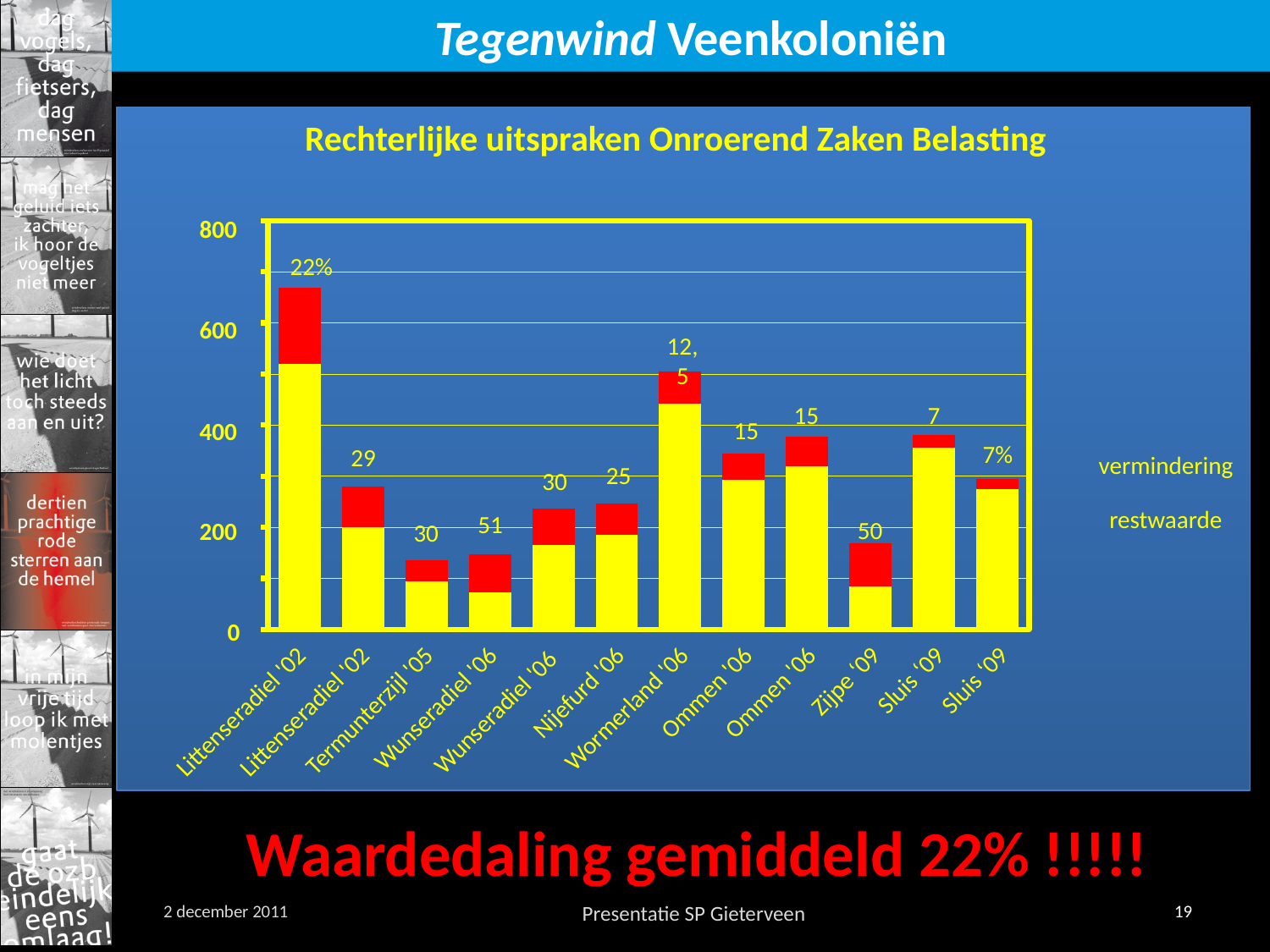
Is the total value of the first Littenseradiel '02 bar greater or less than 600? greater Which two series are listed in the legend? vermindering, restwaarde What kind of chart is shown on the slide? stacked bar chart Which bar is taller, Wormerland '06 or Nijefurd '06? Wormerland '06 How many series does the legend list? 2 What is the title of the chart? Rechterlijke uitspraken Onroerend Zaken Belasting What data label is shown above the Wormerland '06 bar? 12,5 What data label is shown above the Nijefurd '06 bar? 25 Is the total value of the Termunterzijl '05 bar greater or less than 200? less How many bars (categories) are plotted in the chart? 12 Which category has the tallest bar? Littenseradiel '02 (first bar) What data label is shown above the Zijpe '09 bar? 50